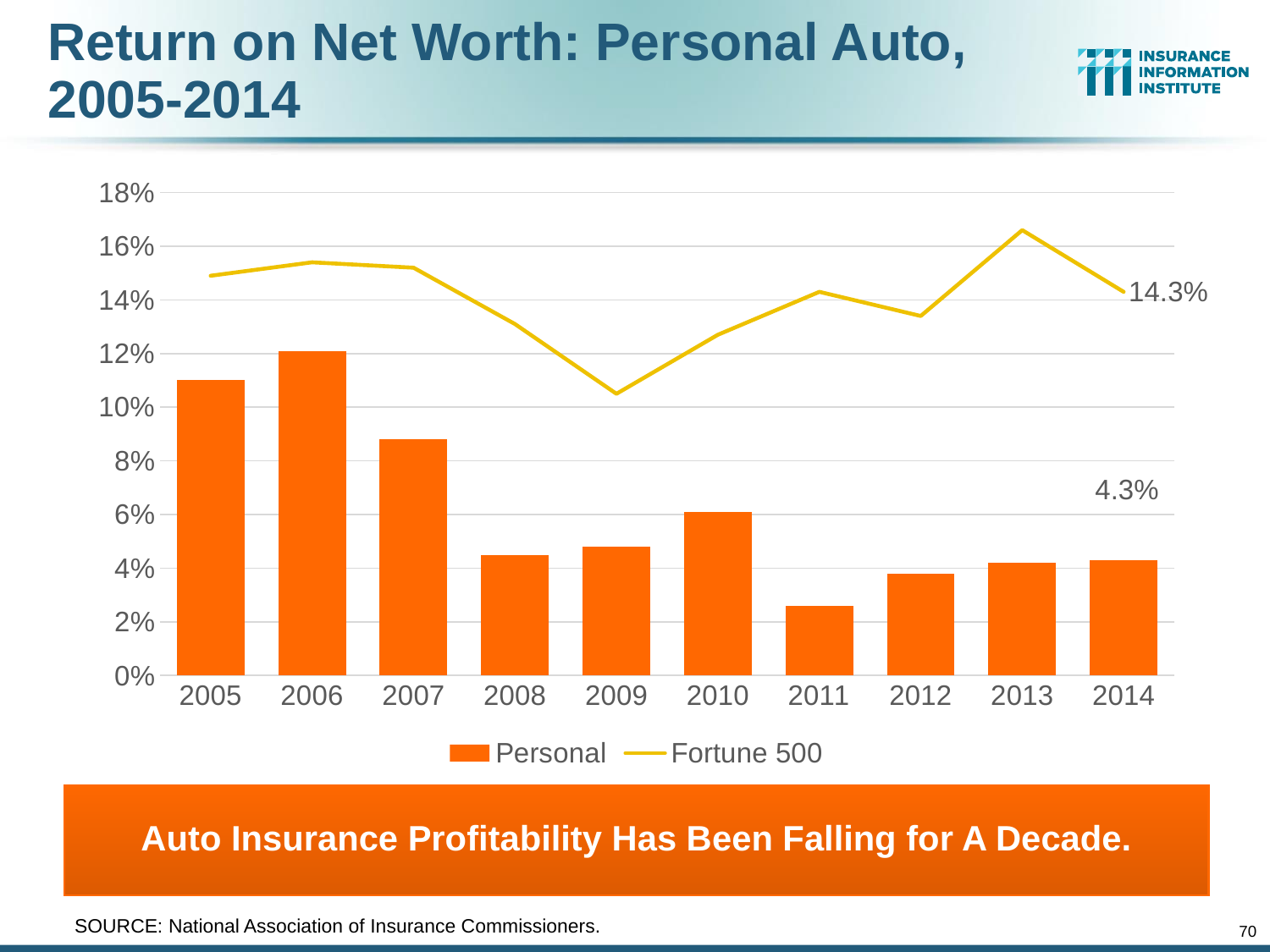
What is the difference between the Fortune 500 and Personal values in 2014? 10.0% What is the Personal return on net worth for 2014? 4.3% In which year does the Fortune 500 line reach its lowest point? 2009 How many years are shown on the x axis? 10 Which year has the larger Personal value, 2005 or 2007? 2005 Is the Personal value for 2011 greater or less than 4%? less How many series does the legend list? 2 In which year does the Fortune 500 line reach its highest point? 2013 What is the Fortune 500 return on net worth for 2014? 14.3% In which year is the Personal return on net worth lowest? 2011 Overall, do the Personal bars rise or fall from 2005 to 2014? fall In which year is the Personal return on net worth highest? 2006